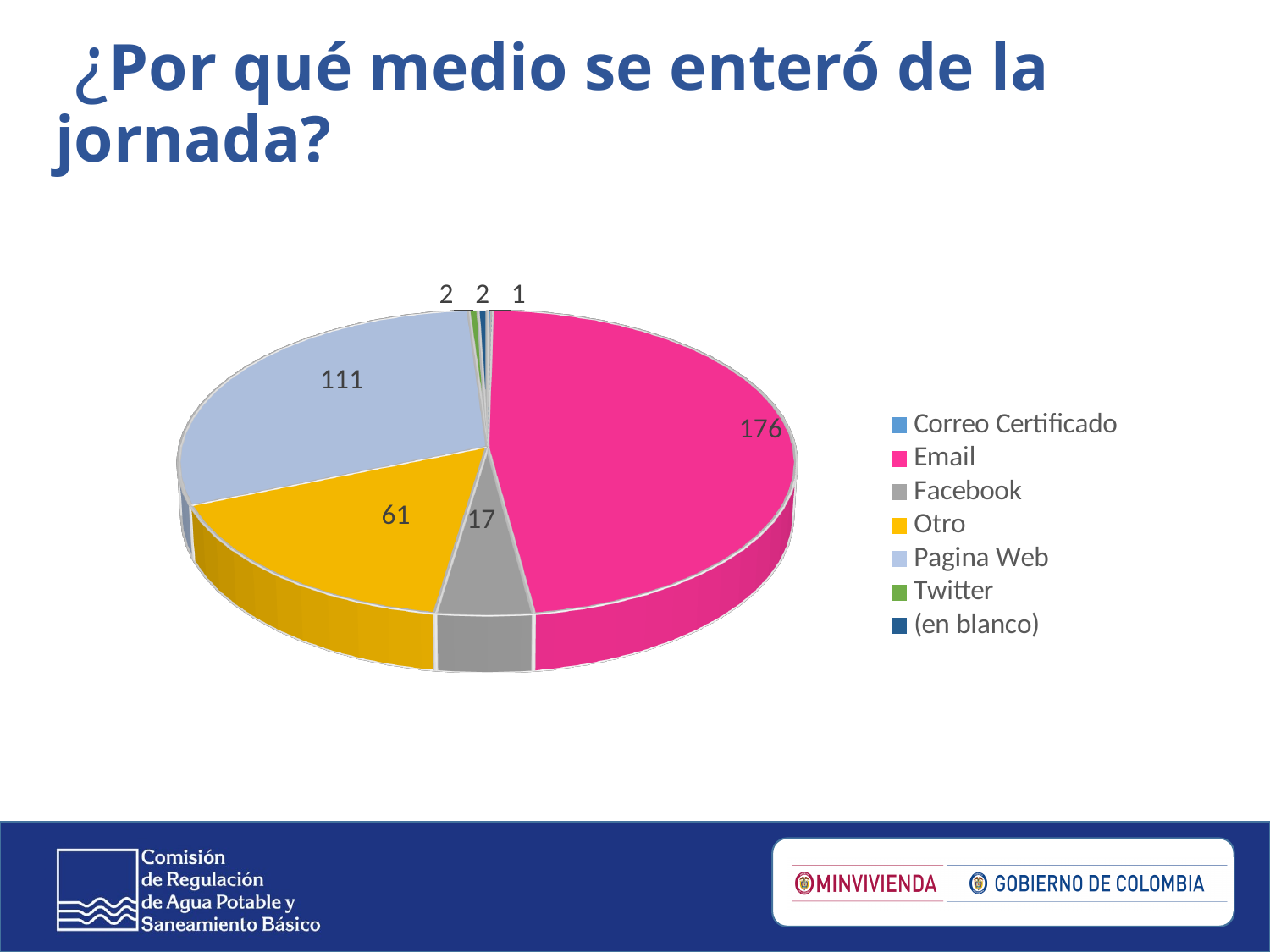
What is the value for Pagina Web? 111 What kind of chart is shown on the slide? Pie chart What is the difference between the values for Email and Pagina Web? 65 What is the difference between the values for Otro and Facebook? 44 What is the title of the slide containing the chart? ¿Por qué medio se enteró de la jornada? What is the value for Facebook? 17 Which category has the largest slice? Email What colour is the Email slice? Pink Which is larger, Pagina Web or Otro? Pagina Web What is the value for Email? 176 What is the value for Otro? 61 How many categories does the legend list? 7